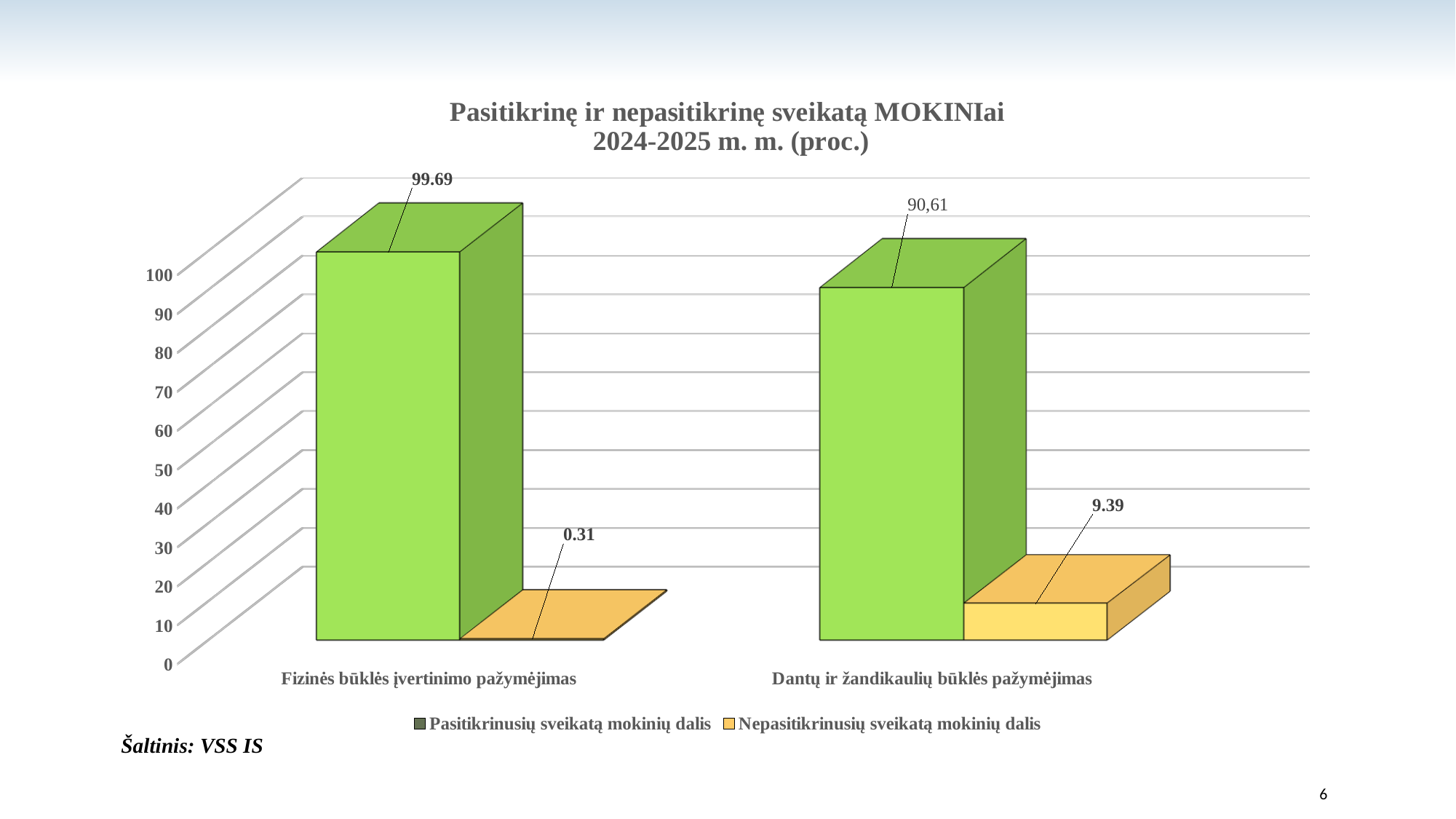
Which category has the lowest value for 'Nepasitikrinusių sveikatą mokinių dalis'? Fizinės būklės įvertinimo pažymėjimas Which category has the higher value for 'Pasitikrinusių sveikatą mokinių dalis'? Fizinės būklės įvertinimo pažymėjimas What is the value of 'Pasitikrinusių sveikatą mokinių dalis' for 'Fizinės būklės įvertinimo pažymėjimas'? 99.69 Is the 'Nepasitikrinusių sveikatą mokinių dalis' value for 'Dantų ir žandikaulių būklės pažymėjimas' greater or less than 20? less How many categories are shown on the x axis? 2 What is the value of 'Pasitikrinusių sveikatą mokinių dalis' for 'Dantų ir žandikaulių būklės pažymėjimas'? 90,61 What is the difference between the 'Nepasitikrinusių sveikatą mokinių dalis' values for 'Dantų ir žandikaulių būklės pažymėjimas' and 'Fizinės būklės įvertinimo pažymėjimas'? 9.08 Is the 'Pasitikrinusių sveikatą mokinių dalis' value larger for 'Fizinės būklės įvertinimo pažymėjimas' or for 'Dantų ir žandikaulių būklės pažymėjimas'? Fizinės būklės įvertinimo pažymėjimas How many series does the legend list? 2 What kind of chart is shown on the slide? bar chart What is the value of 'Nepasitikrinusių sveikatą mokinių dalis' for 'Fizinės būklės įvertinimo pažymėjimas'? 0.31 What is the value of 'Nepasitikrinusių sveikatą mokinių dalis' for 'Dantų ir žandikaulių būklės pažymėjimas'? 9.39